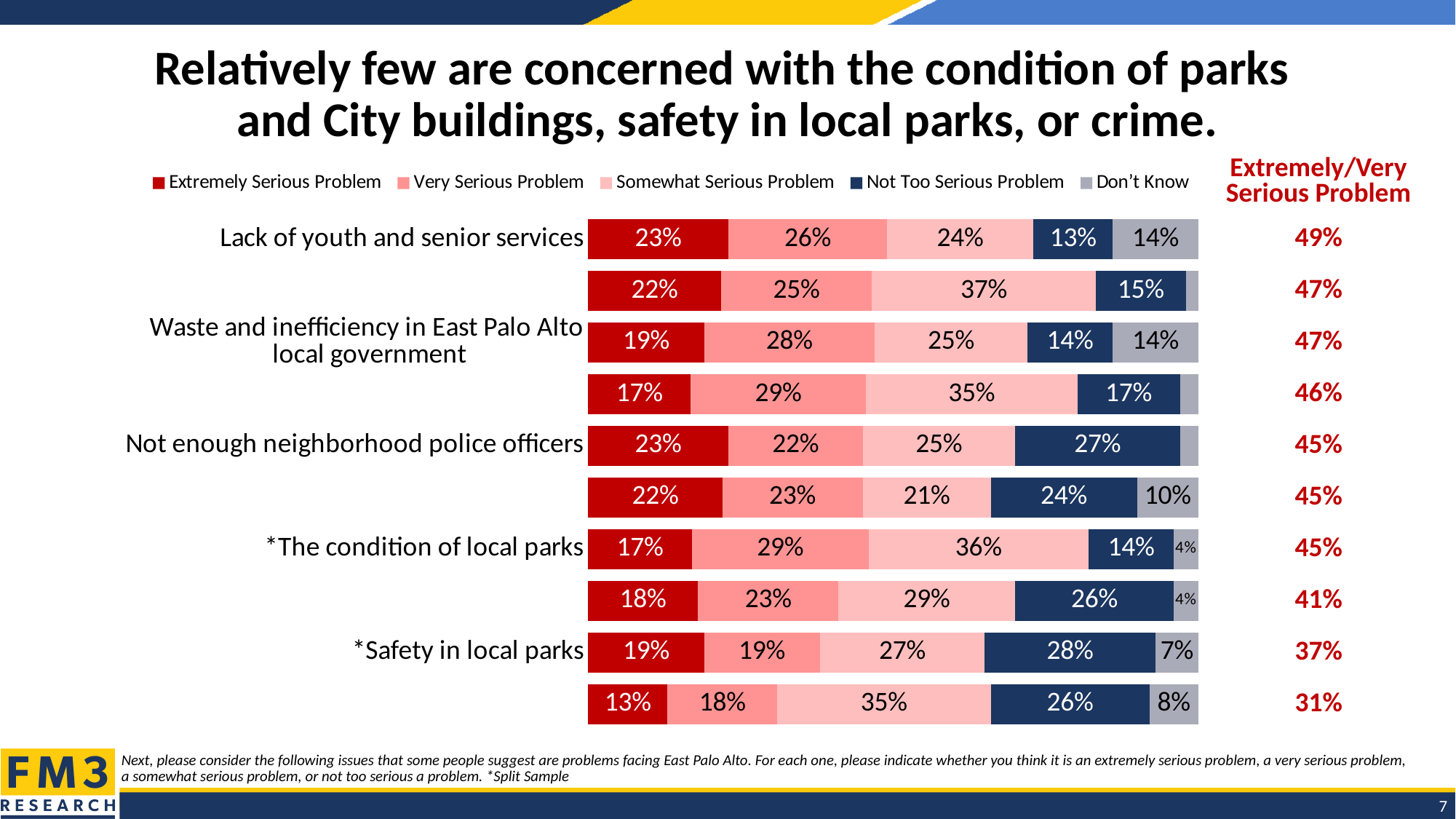
What percentage rated "Lack of youth and senior services" an Extremely Serious Problem? 23% What is the Don't Know percentage for "Safety in local parks"? 7% What percentage rated "Not enough neighborhood police officers" a Not Too Serious Problem? 27% Which item has the highest combined Extremely/Very Serious Problem percentage? Lack of youth and senior services How many response categories does the legend list? 5 What is the sum of the Extremely Serious and Very Serious Problem shares for "Waste and inefficiency in East Palo Alto local government"? 47% What is the combined Extremely/Very Serious Problem percentage shown for "Safety in local parks"? 37% Which has a larger Somewhat Serious Problem share: "The condition of local parks" or "Lack of youth and senior services"? The condition of local parks What percentage rated "The condition of local parks" a Somewhat Serious Problem? 36% What type of chart is shown on the slide? Stacked bar chart What percentage rated "Waste and inefficiency in East Palo Alto local government" a Very Serious Problem? 28% How many percentage points higher is the Extremely Serious Problem share for "Lack of youth and senior services" than for "Waste and inefficiency in East Palo Alto local government"? 4 percentage points